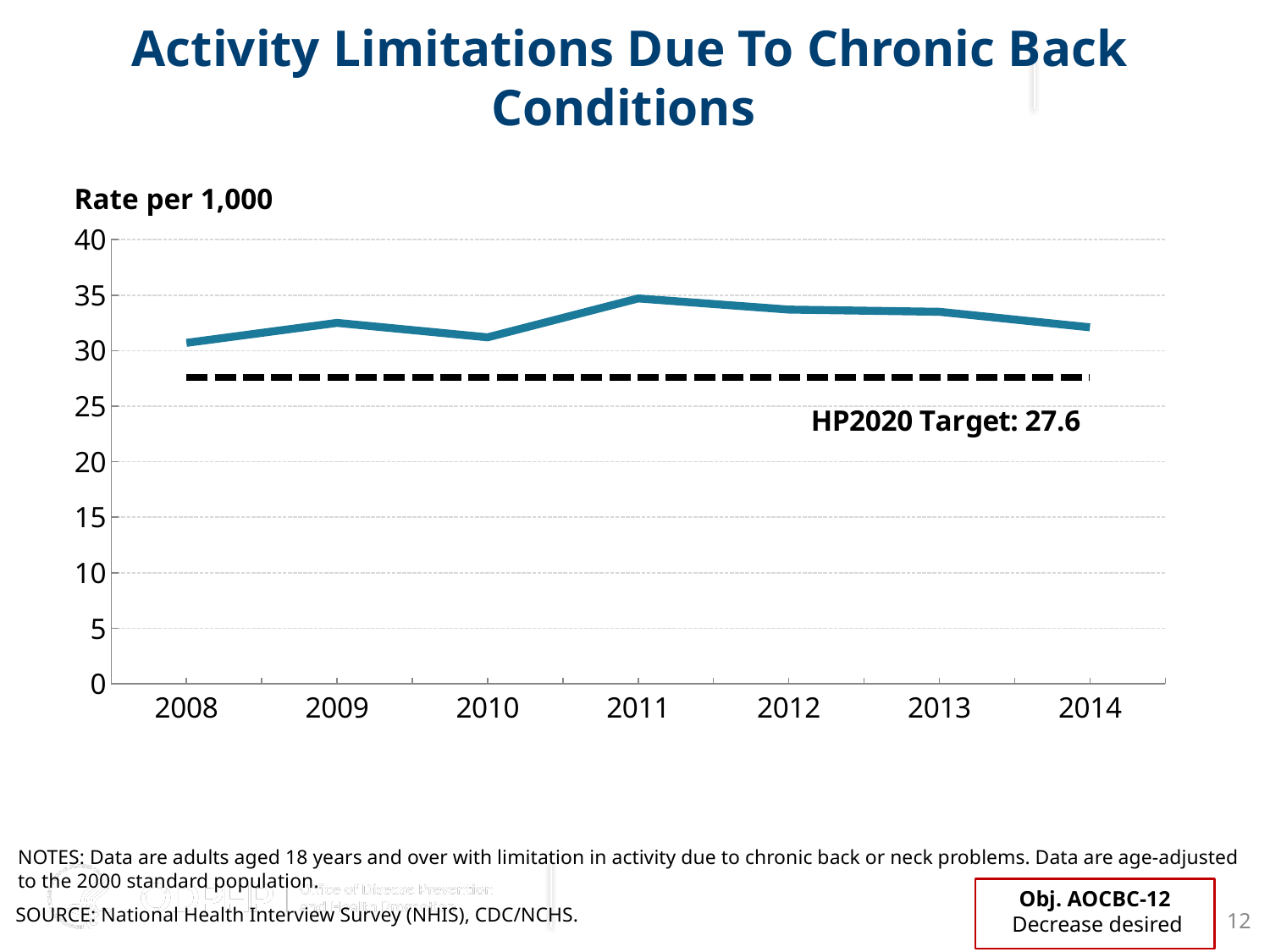
Is the value for 2011 greater or less than 30? greater How many years are plotted along the x axis of the chart? 7 In which year is the rate of activity limitations due to chronic back conditions lowest? 2008 Do the values rise or fall from 2011 to 2014? fall Which year has the larger value, 2011 or 2008? 2011 In which year is the rate of activity limitations due to chronic back conditions highest? 2011 What is the HP2020 Target value shown on the chart? 27.6 Which year has the larger value, 2009 or 2010? 2009 Is the value for 2008 greater or less than 35? less Is the value for 2014 greater or less than 30? greater What unit is the y axis of the chart labelled with? Rate per 1,000 What kind of chart is shown on the slide? line chart